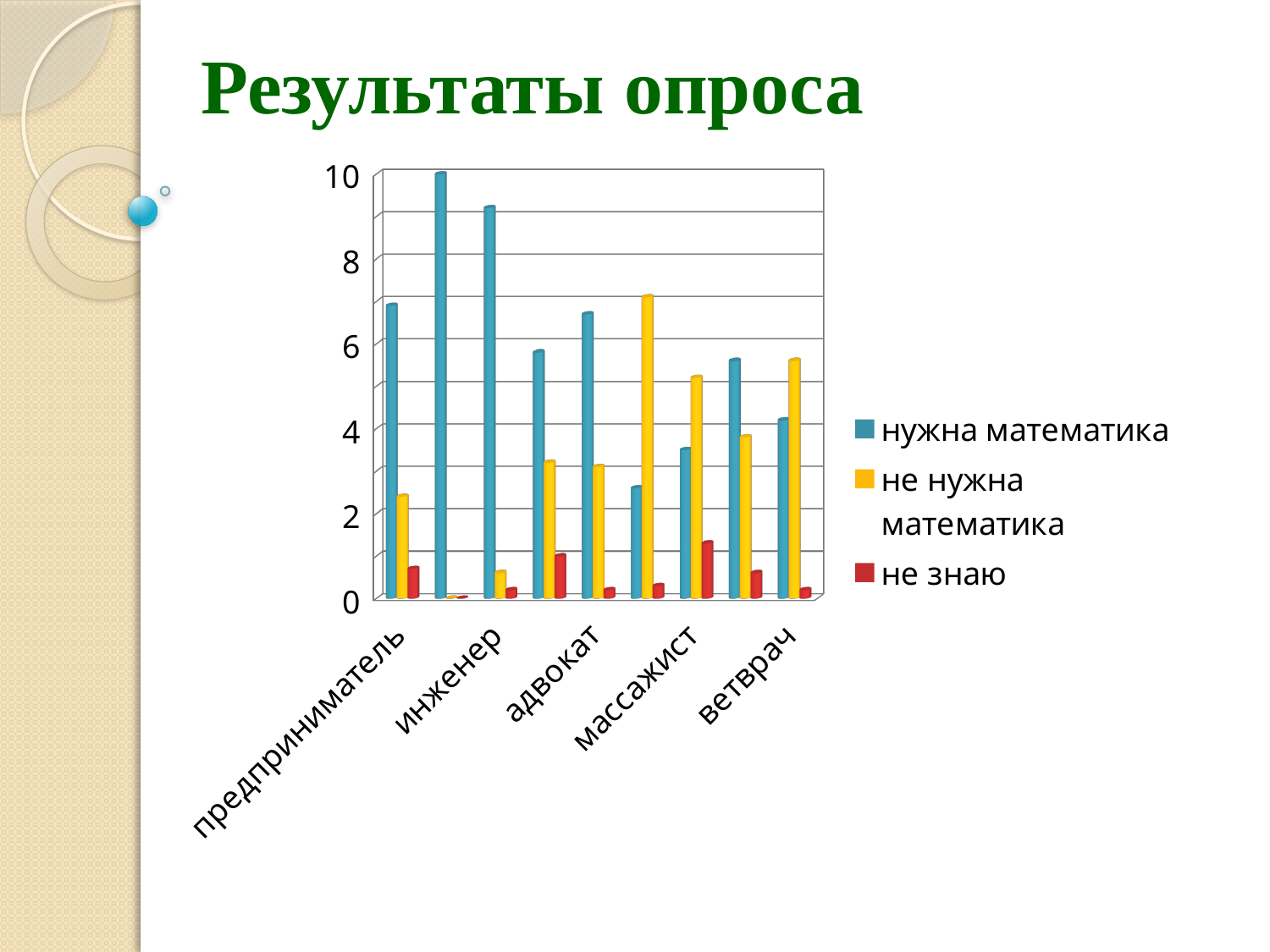
Which series is shown in red in the legend? не знаю For массажист, which is larger: "нужна математика" or "не нужна математика"? не нужна математика Is the value of "нужна математика" for предприниматель greater or less than 6? greater For ветврач, which is larger: "нужна математика" or "не нужна математика"? не нужна математика What is the title of the slide above the chart? Результаты опроса For предприниматель, which is larger: "нужна математика" or "не нужна математика"? нужна математика Is the value of "не нужна математика" for массажист greater or less than 4? greater How many series does the legend list? 3 What kind of chart is shown on the slide? bar chart Is the value of "нужна математика" for инженер greater or less than 8? greater